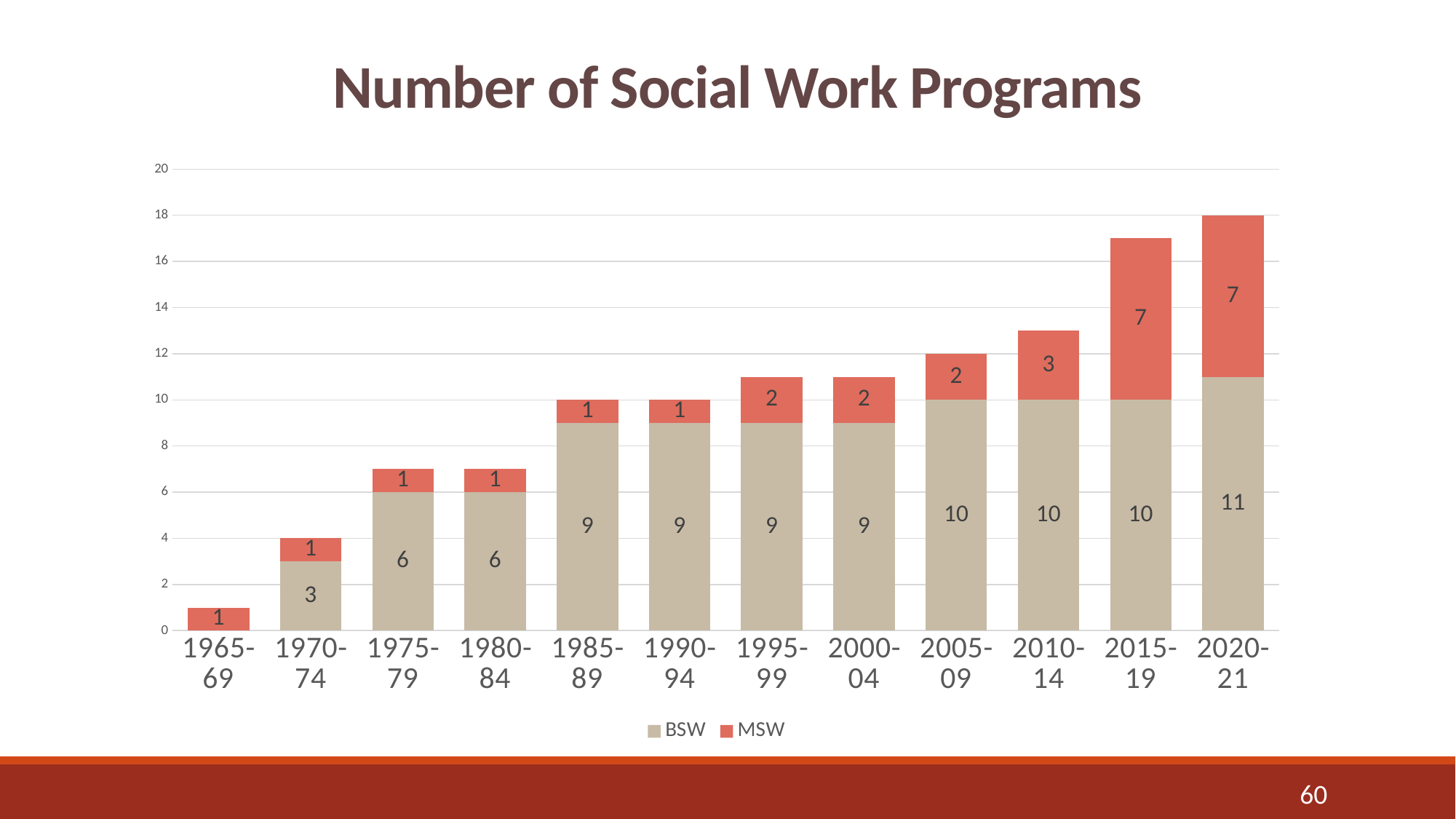
What is the MSW value for 2010-14? 3 Which period has the lowest total number of programs? 1965-69 Which period has the highest BSW value? 2020-21 What is the total number of programs in the stacked bar for 1995-99? 11 Which is larger, the MSW value for 2015-19 or the MSW value for 2005-09? 2015-19 What is the BSW value for 2020-21? 11 How many series does the legend list? 2 What kind of chart is shown on the slide? Stacked bar chart What is the total number of programs in the stacked bar for 2015-19? 17 What is the BSW value for 1970-74? 3 What is the difference between the BSW value for 2020-21 and the BSW value for 1975-79? 5 How many time periods are shown on the x axis? 12